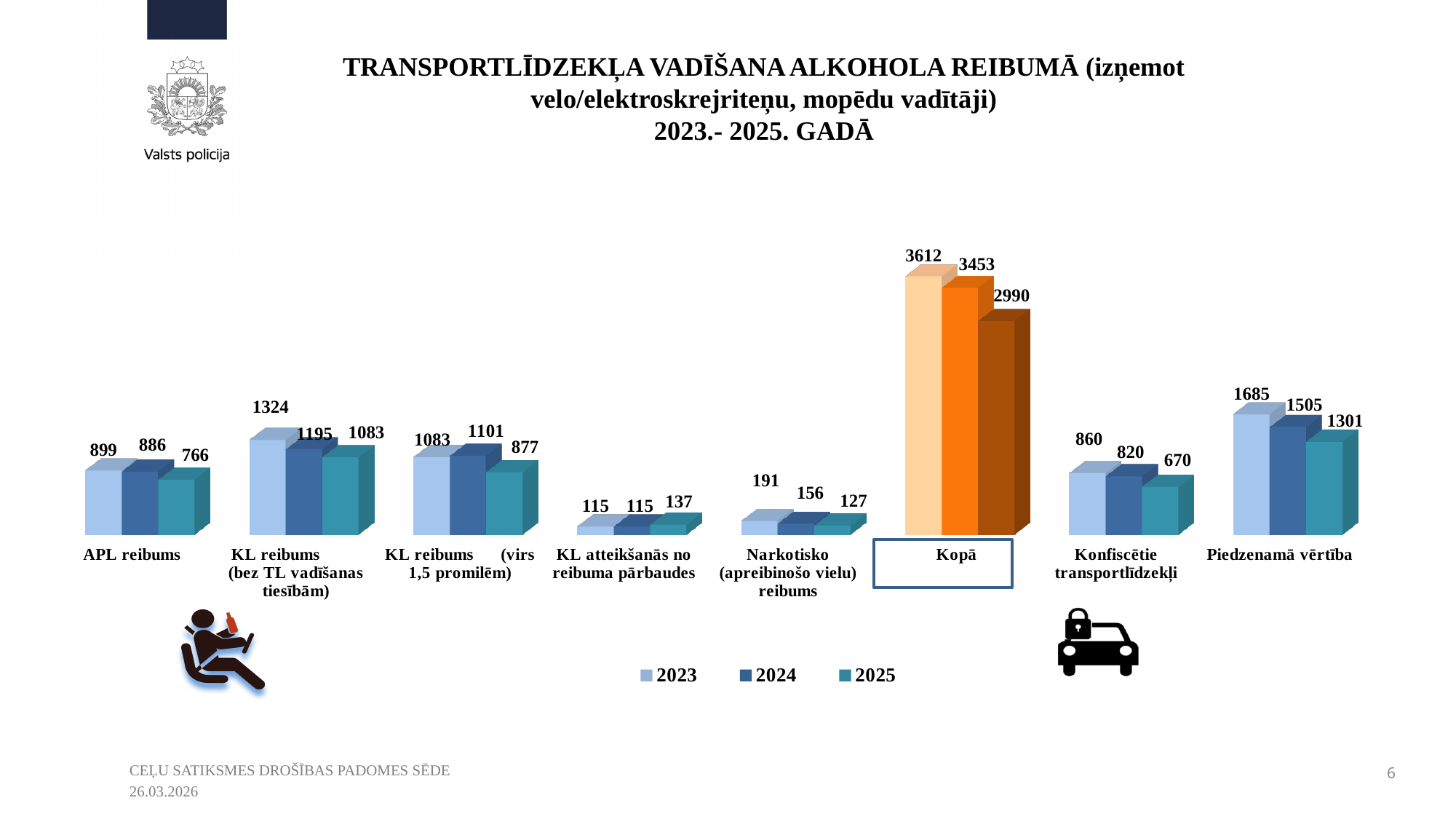
What is the value for APL reibums in 2023? 899 What kind of chart is shown on the slide? Bar chart Which category has the highest value in 2023? Kopā What is the 2025 value for KL atteikšanās no reibuma pārbaudes? 137 Which is larger for KL reibums (virs 1,5 promilēm): the 2023 value or the 2024 value? 2024 What is the difference between the 2023 and 2024 values for Konfiscētie transportlīdzekļi? 40 Which category has the lowest value in 2024? KL atteikšanās no reibuma pārbaudes How many series does the legend list? 3 How many categories are shown on the x axis? 8 What is the 2024 value for Piedzenamā vērtība? 1505 What is the 2025 value for Kopā? 2990 What is the difference between the 2023 and 2025 values for Kopā? 622